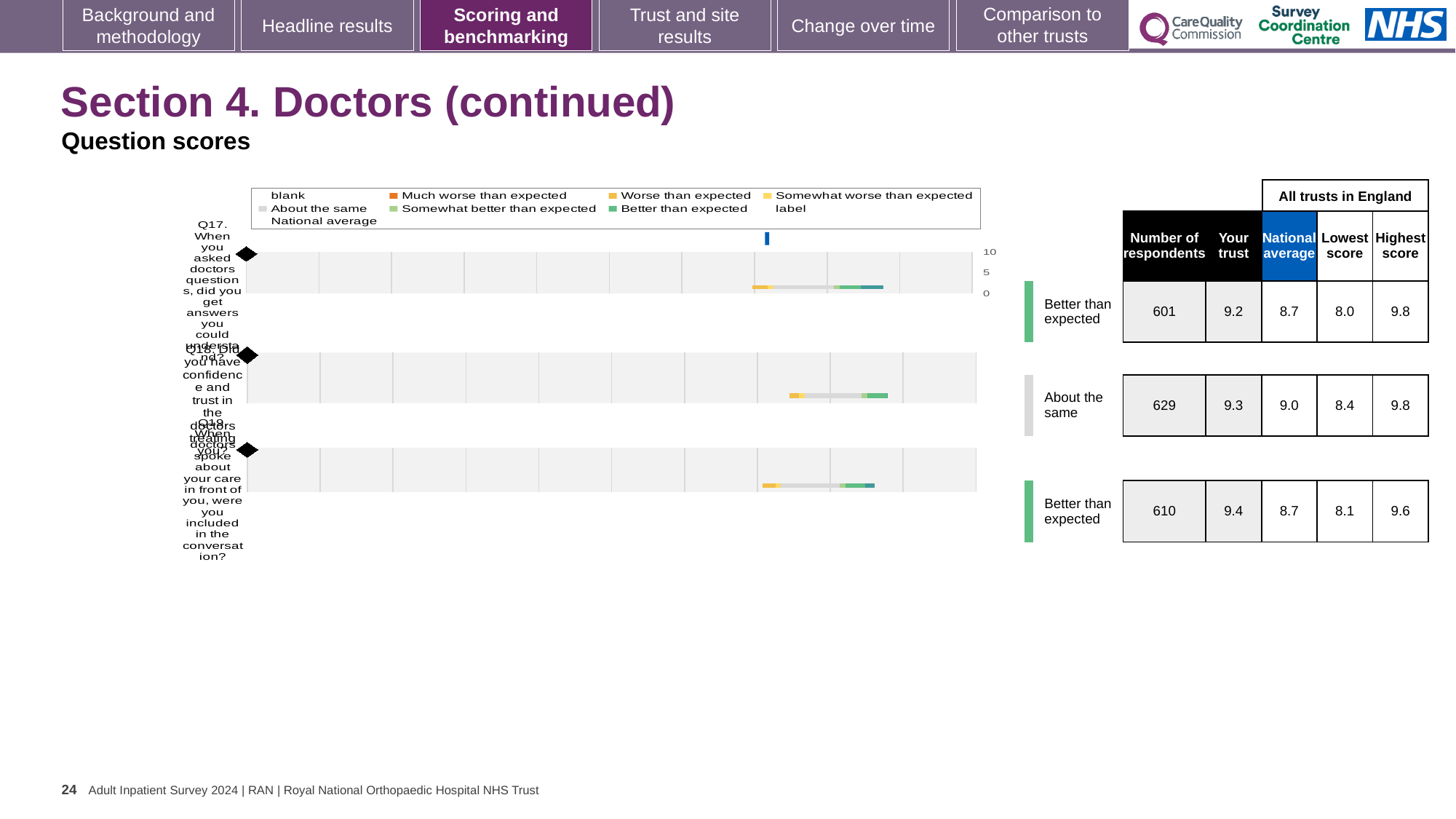
What is the difference between the 'Your trust' score and the national average for Q17? 0.5 For Q18, which is larger: the 'Your trust' score or the national average? Your trust What kind of chart is shown on the slide? bar chart What is the highest score among all trusts in England for Q19? 9.6 Which question has the fewest respondents? Q17 What benchmark category is shown for Q18? About the same What is the difference between the highest and lowest scores for Q19? 1.5 What is the national average score for Q18 (Did you have confidence and trust in the doctors treating you)? 9.0 How many questions (bars) are plotted in the chart? 3 What is the 'Your trust' score for Q17 (When you asked doctors questions, did you get answers you could understand)? 9.2 Which question has the highest 'Your trust' score? Q19 How many respondents answered Q19 (When doctors spoke about your care in front of you, were you included in the conversation)? 610